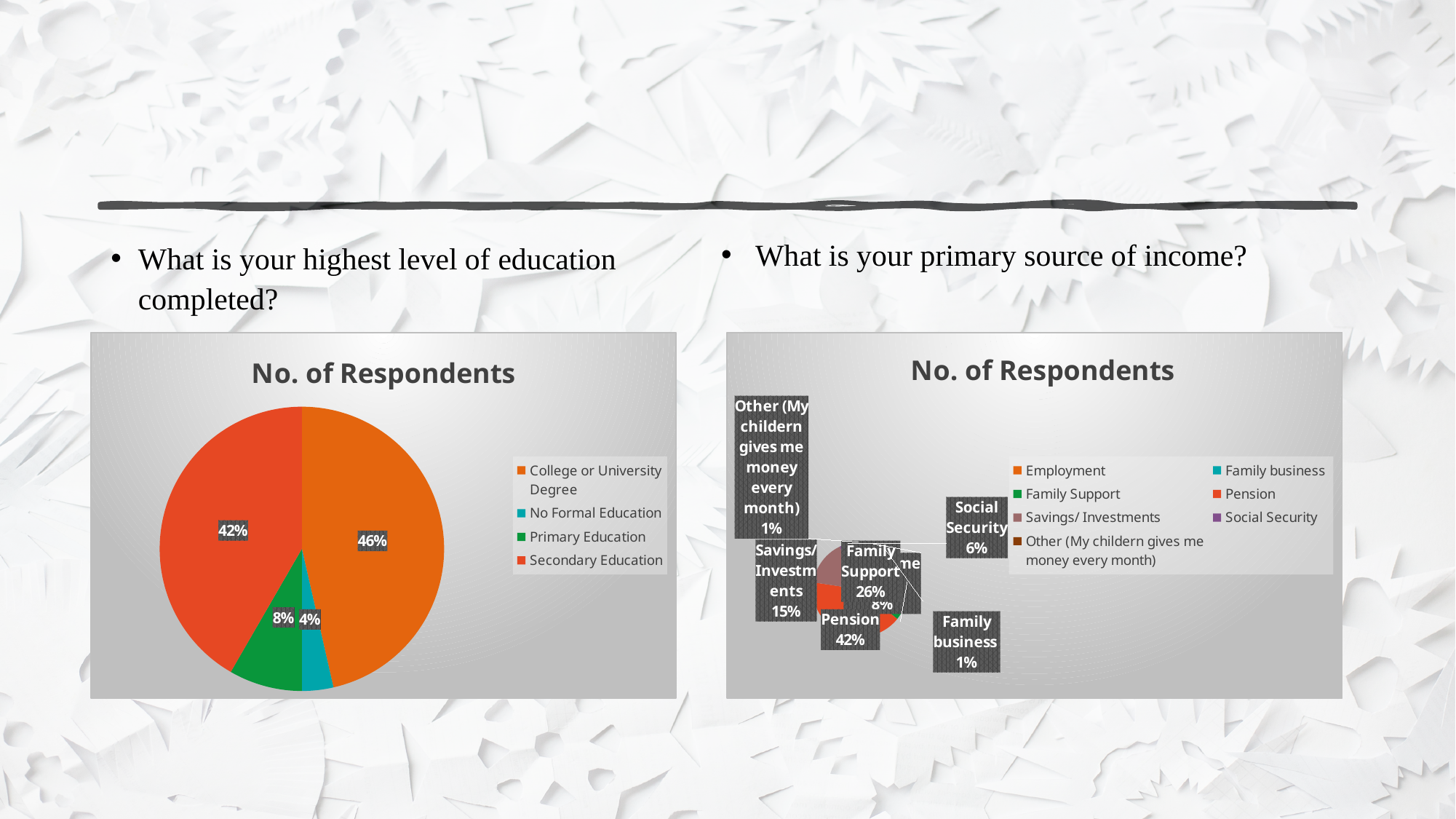
What type of chart is the left chart (highest level of education)? Pie chart On the left chart (highest level of education), which category has the smallest share? No Formal Education On the right chart (primary source of income), which is larger: Family Support or Social Security? Family Support On the left chart (highest level of education), how many categories does the legend list? 4 On the right chart (primary source of income), what percentage of respondents rely on Pension? 42% On the left chart (highest level of education), what percentage of respondents have No Formal Education? 4% On the left chart (highest level of education), what is the difference in percentage points between Primary Education and No Formal Education? 4 On the left chart (highest level of education), what percentage of respondents have a College or University Degree? 46% On the right chart (primary source of income), what percentage of respondents rely on Savings/ Investments? 15% On the right chart (primary source of income), how many categories does the legend list? 7 On the left chart (highest level of education), which category has the largest share? College or University Degree On the left chart (highest level of education), what percentage of respondents have Secondary Education? 42%